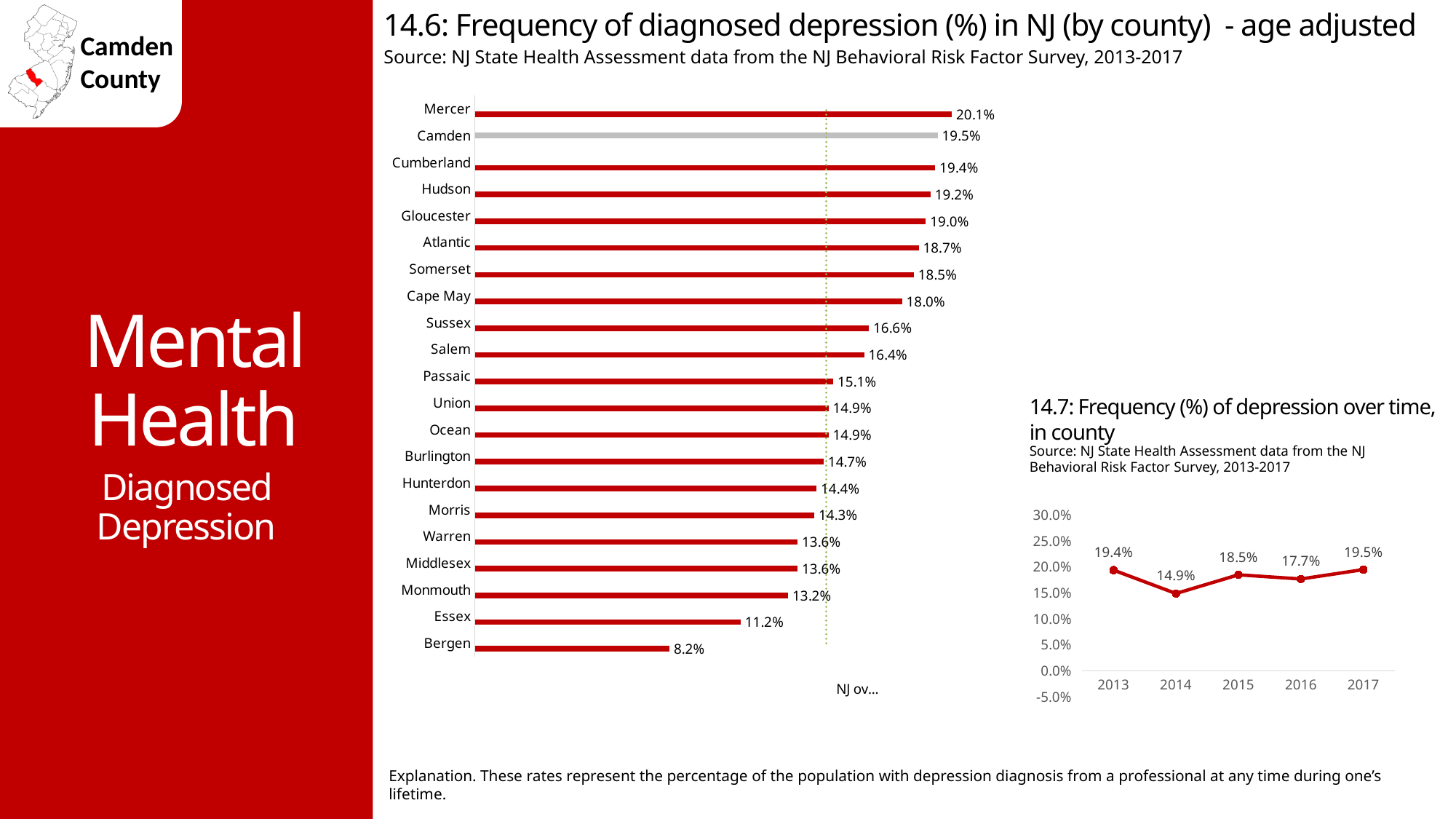
In the chart 14.6 (frequency of diagnosed depression by county), how many counties are plotted? 21 What kind of chart is chart 14.6 (frequency of diagnosed depression by county)? Bar chart In the chart 14.7 (frequency of depression over time in county), which year has the highest value? 2017 In the chart 14.6 (frequency of diagnosed depression by county), which county has the highest value? Mercer In the chart 14.6 (frequency of diagnosed depression by county), what is the difference between Mercer and Bergen? 11.9% In the chart 14.6 (frequency of diagnosed depression by county), what is the value for Camden? 19.5% In the chart 14.7 (frequency of depression over time in county), what is the value for 2014? 14.9% In the chart 14.6 (frequency of diagnosed depression by county), what is the value for Essex? 11.2% In the chart 14.6 (frequency of diagnosed depression by county), which is larger, Hudson or Gloucester? Hudson In the chart 14.7 (frequency of depression over time in county), what is the difference between 2017 and 2016? 1.8% In the chart 14.6 (frequency of diagnosed depression by county), which county has the lowest value? Bergen What kind of chart is chart 14.7 (frequency of depression over time in county)? Line chart